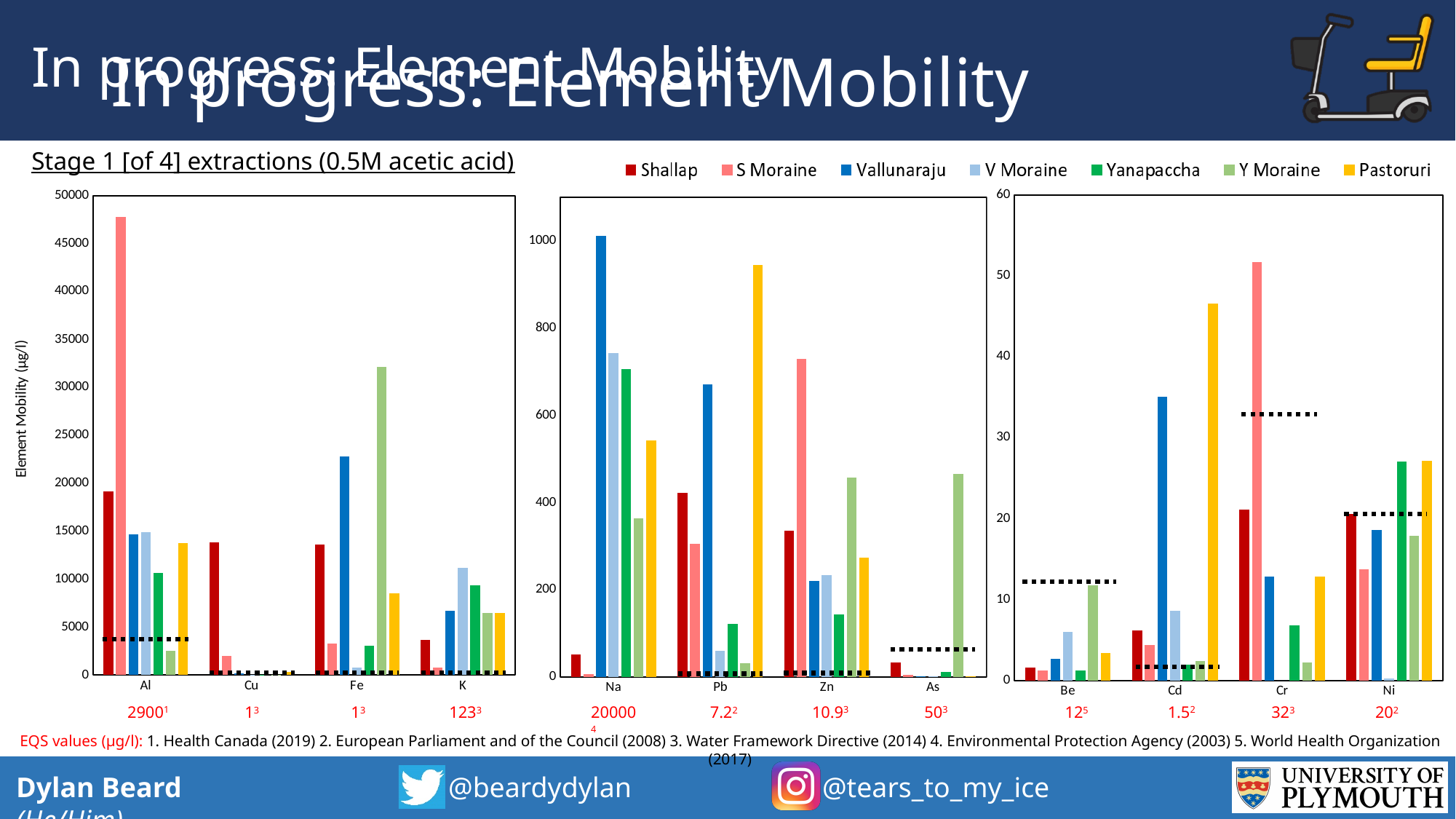
In the middle chart, which is larger for Na: Vallunaraju or Pastoruri? Vallunaraju What kind of chart is the left chart on the slide? bar chart In the left chart, which series has the highest value for Fe? Y Moraine How many categories are shown on the x axis of the middle chart? 4 In the middle chart, which series has the highest value for Pb? Pastoruri In the right chart, which series has the highest value for Cr? S Moraine What is the y-axis label of the left chart? Element Mobility (µg/l) In the right chart, is the value for Vallunaraju at Cd greater or less than 30? greater How many series does the shared legend list? 7 In the middle chart, is the value for S Moraine at Zn greater or less than 600? greater In the left chart, is the value for S Moraine at Al greater or less than 45000? greater